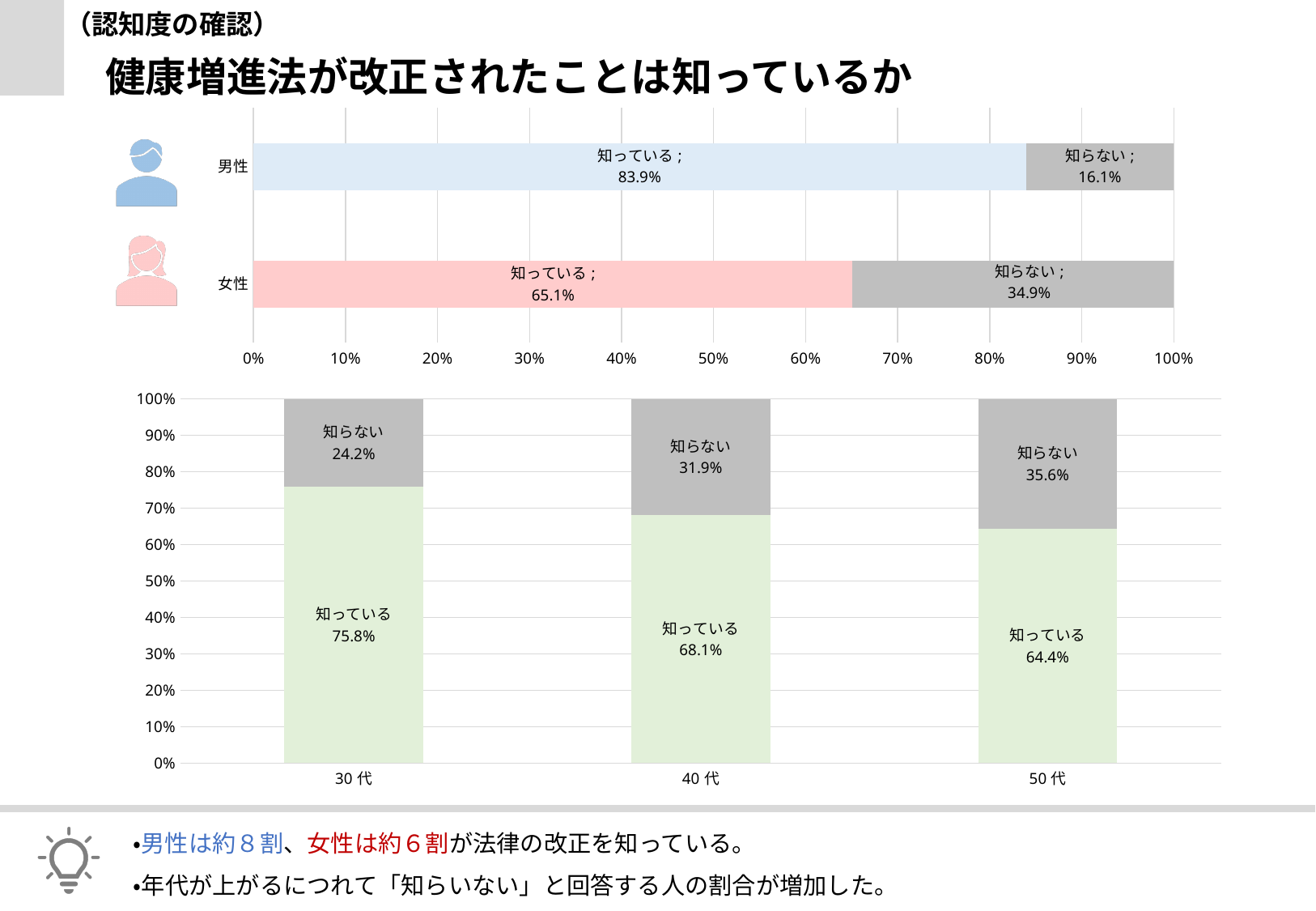
In the top chart (by gender), which group has the higher 知っている share, 男性 or 女性? 男性 In the bottom chart (by age group), which age group has the lowest 知っている share? 50代 In the top chart (by gender), what kind of chart is shown? Stacked bar chart In the top chart (by gender), what is the difference between the 知っている shares of 男性 and 女性? 18.8% In the top chart (by gender), what percentage of women (女性) answered 知らない? 34.9% In the bottom chart (by age group), what is the difference between the 知らない shares of 30代 and 40代? 7.7% In the bottom chart (by age group), does the 知らない share rise or fall as the age group increases from 30代 to 50代? Rises In the bottom chart (by age group), what percentage of 50代 answered 知らない? 35.6% In the top chart (by gender), what percentage of men (男性) answered 知っている? 83.9% In the bottom chart (by age group), how many age groups are shown? 3 In the bottom chart (by age group), what percentage of 40代 answered 知っている? 68.1% In the bottom chart (by age group), which age group has the highest 知らない share? 50代